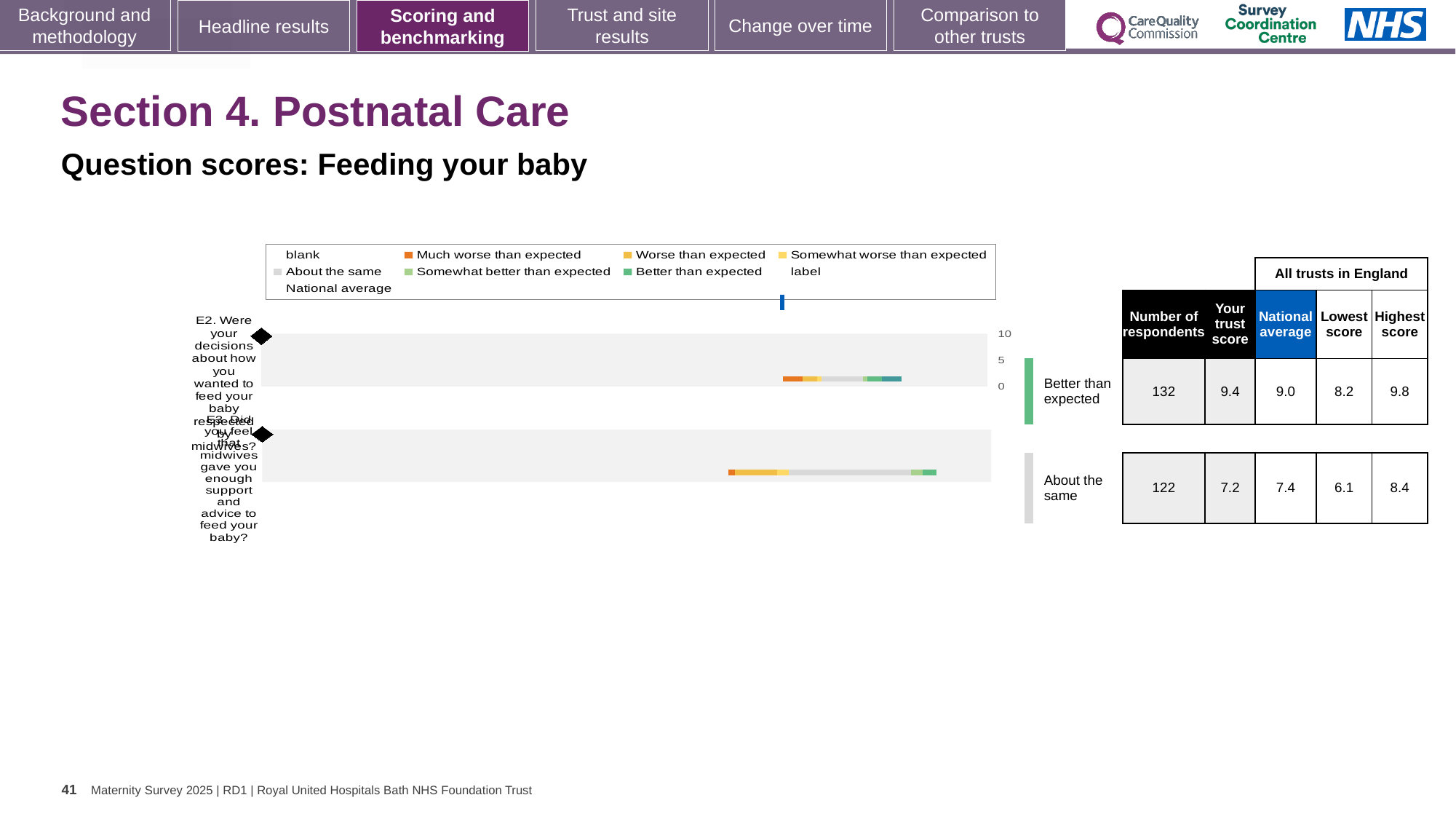
What is the highest score among all trusts in England for question E2? 9.8 What is the national average score for question E3? 7.4 What is the trust score for question E2 (decisions about how you wanted to feed your baby respected by midwives)? 9.4 How many respondents answered question E2? 132 Which question has the higher trust score, E2 or E3? E2 What is the difference between the highest score and the lowest score for question E3? 2.3 For question E3, is the trust score higher or lower than the national average? lower What is the trust score for question E3 (midwives gave you enough support and advice to feed your baby)? 7.2 Which benchmark category is question E2 placed in? Better than expected How many entries does the chart legend list? 9 How many questions (categories) are plotted in the chart? 2 What kind of chart is shown on the slide? bar chart